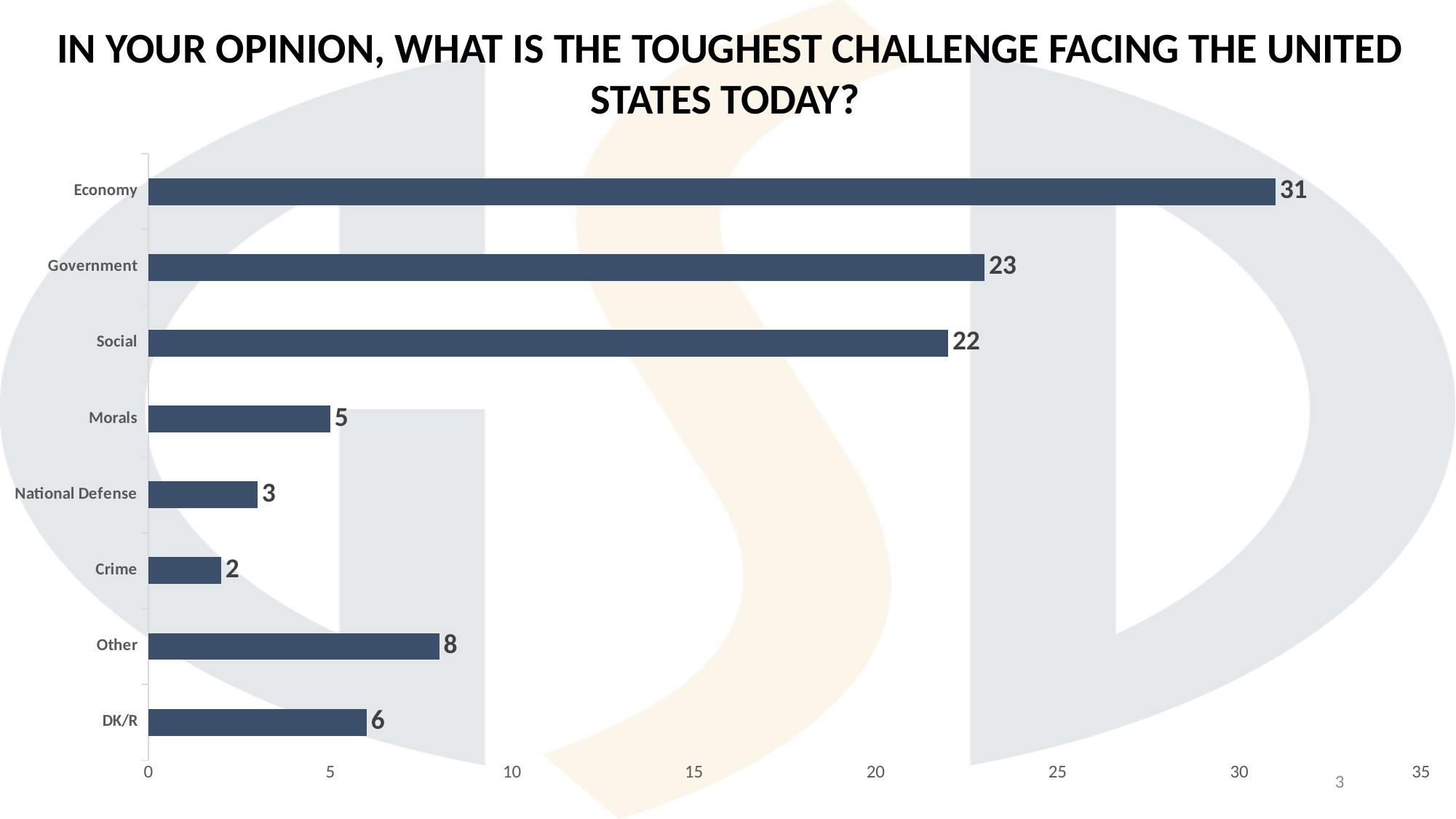
What is the value for Economy? 31 What is the value for DK/R? 6 What is the difference between the values for Other and Morals? 3 What is the value for National Defense? 3 Which is larger, the value for Social or the value for Other? Social What is the value for Government? 23 What kind of chart is shown on the slide? Bar chart Which category has the highest value? Economy Which category has the lowest value? Crime What is the difference between the values for Economy and Government? 8 How many categories are shown in the chart? 8 Is the value for Social greater or less than 20? greater